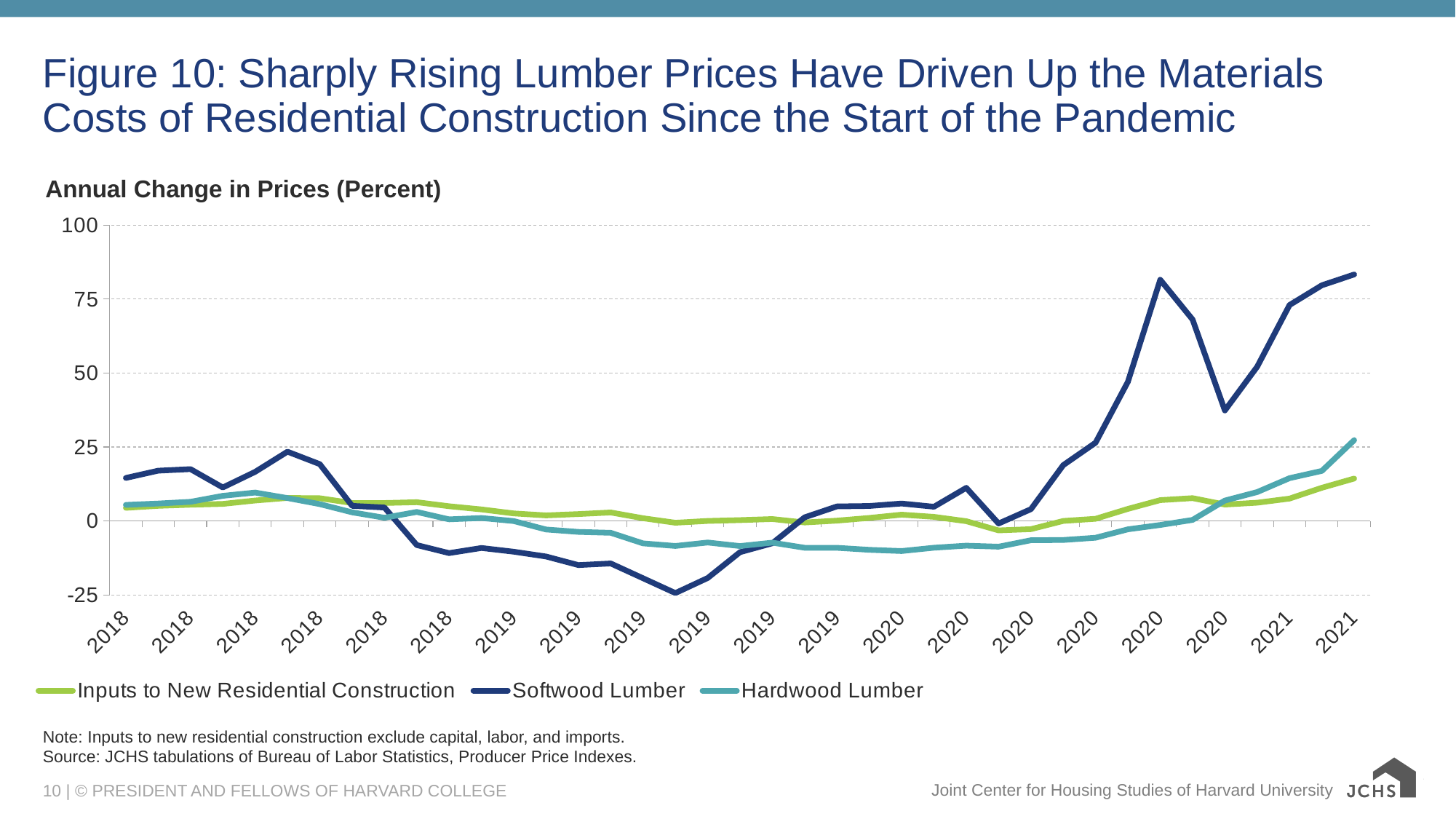
Is the peak value for Softwood Lumber greater or less than 75? greater Is the final 2021 value for Hardwood Lumber greater or less than 0? greater What is the highest value shown on the vertical axis? 100 Do the Softwood Lumber values rise or fall across the 2021 points at the right end of the chart? Rise What is the label of the vertical axis? Annual Change in Prices (Percent) Is the lowest value for Softwood Lumber greater or less than 0? less Which series reaches the lowest value on the chart? Softwood Lumber Which series reaches the highest value on the chart? Softwood Lumber How many series does the legend list? 3 At the last point in 2021, which is larger: Softwood Lumber or Hardwood Lumber? Softwood Lumber What kind of chart is shown on the slide? Line chart